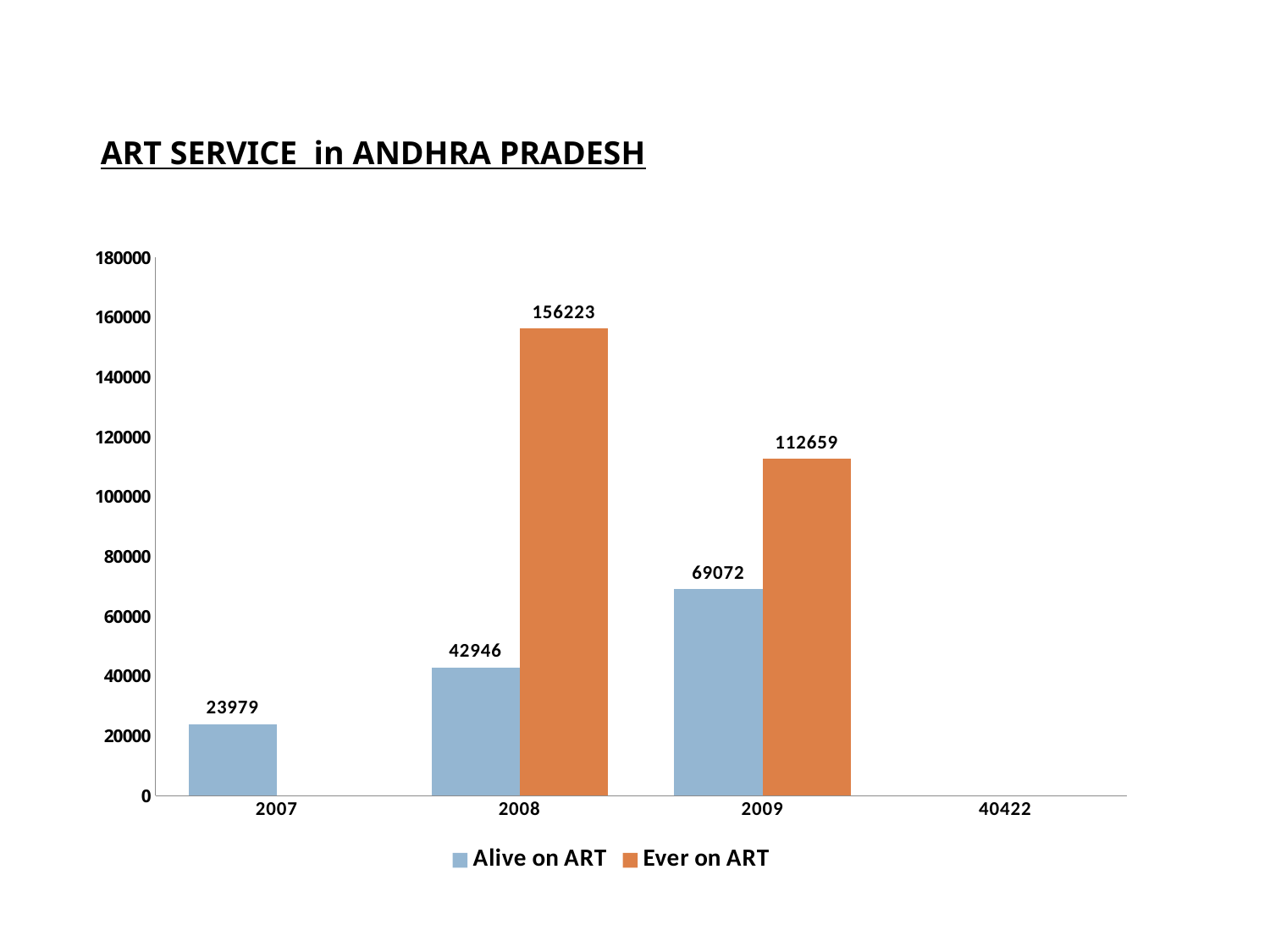
Which year has the highest Ever on ART value? 2008 What is the value for Alive on ART in 2009? 69072 What is the value for Alive on ART in 2007? 23979 What is the difference between Alive on ART in 2009 and Alive on ART in 2008? 26126 Which is larger: Alive on ART in 2009 or Ever on ART in 2009? Ever on ART in 2009 Which year has the lowest Alive on ART value? 2007 What is the value for Ever on ART in 2009? 112659 How many series does the legend list? 2 What is the value for Ever on ART in 2008? 156223 What is the difference between Ever on ART in 2008 and Ever on ART in 2009? 43564 Does the Alive on ART value rise or fall from 2007 to 2009? Rise What kind of chart is shown on the slide? Bar chart